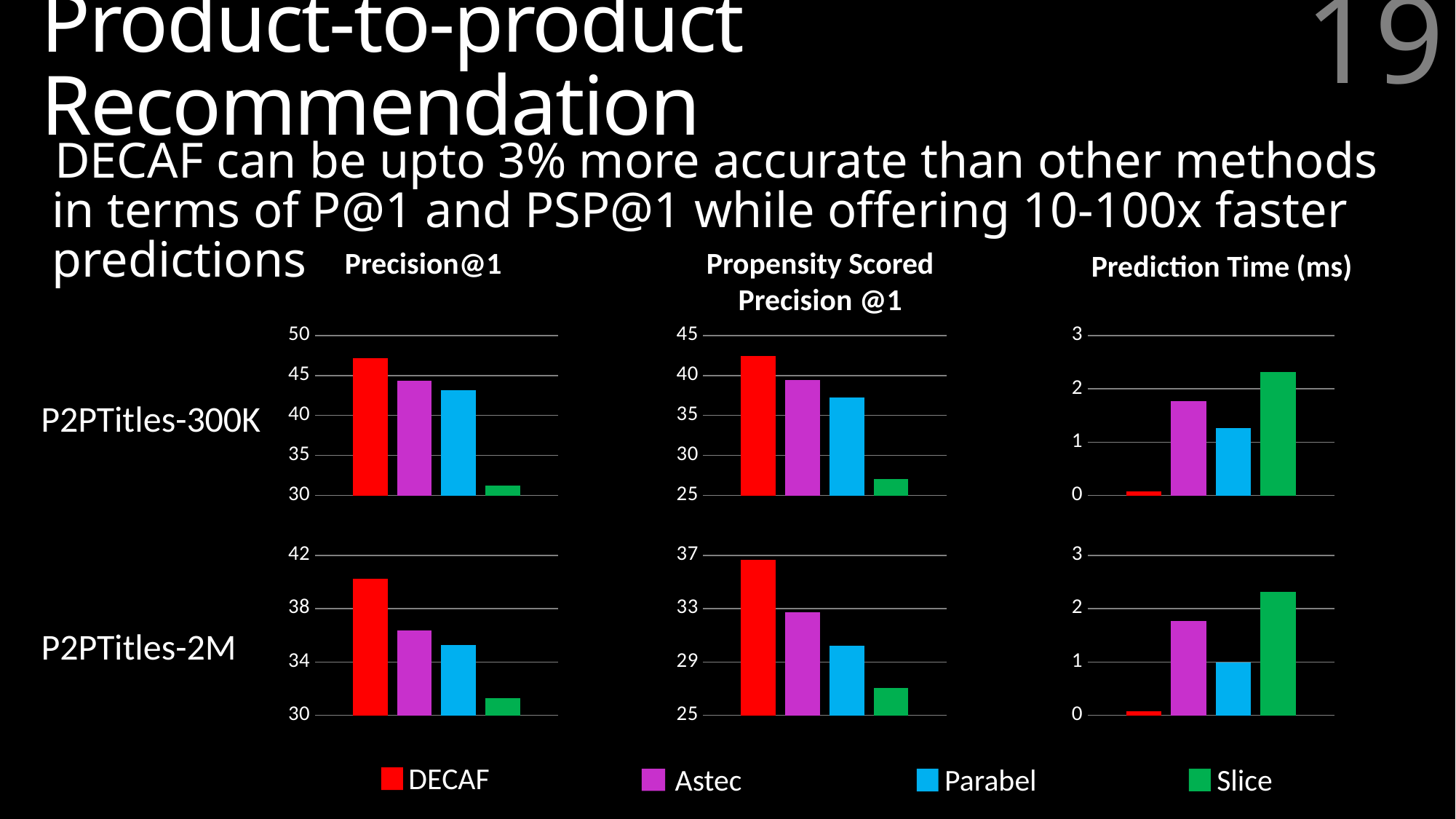
In the Precision@1 chart for P2PTitles-300K, is the value for DECAF greater or less than 45? greater In the Prediction Time (ms) chart for P2PTitles-300K, which method has the lowest prediction time? DECAF In the Propensity Scored Precision @1 chart for P2PTitles-300K, which method has the lowest value? Slice In the Precision@1 chart for P2PTitles-300K, which method has the highest value? DECAF In the Prediction Time (ms) chart for P2PTitles-300K, which method has the highest prediction time? Slice In the Precision@1 chart for P2PTitles-300K, which method has the lowest value? Slice In the Propensity Scored Precision @1 chart for P2PTitles-300K, is the value for Parabel greater or less than 35? greater In the Precision@1 chart for P2PTitles-2M, is the value for DECAF greater or less than 38? greater How many methods does the legend at the bottom of the slide list? 4 In the Propensity Scored Precision @1 chart for P2PTitles-2M, which is larger, the value for Astec or the value for Parabel? Astec What kind of chart is used for the Precision@1 results on this slide? Bar chart